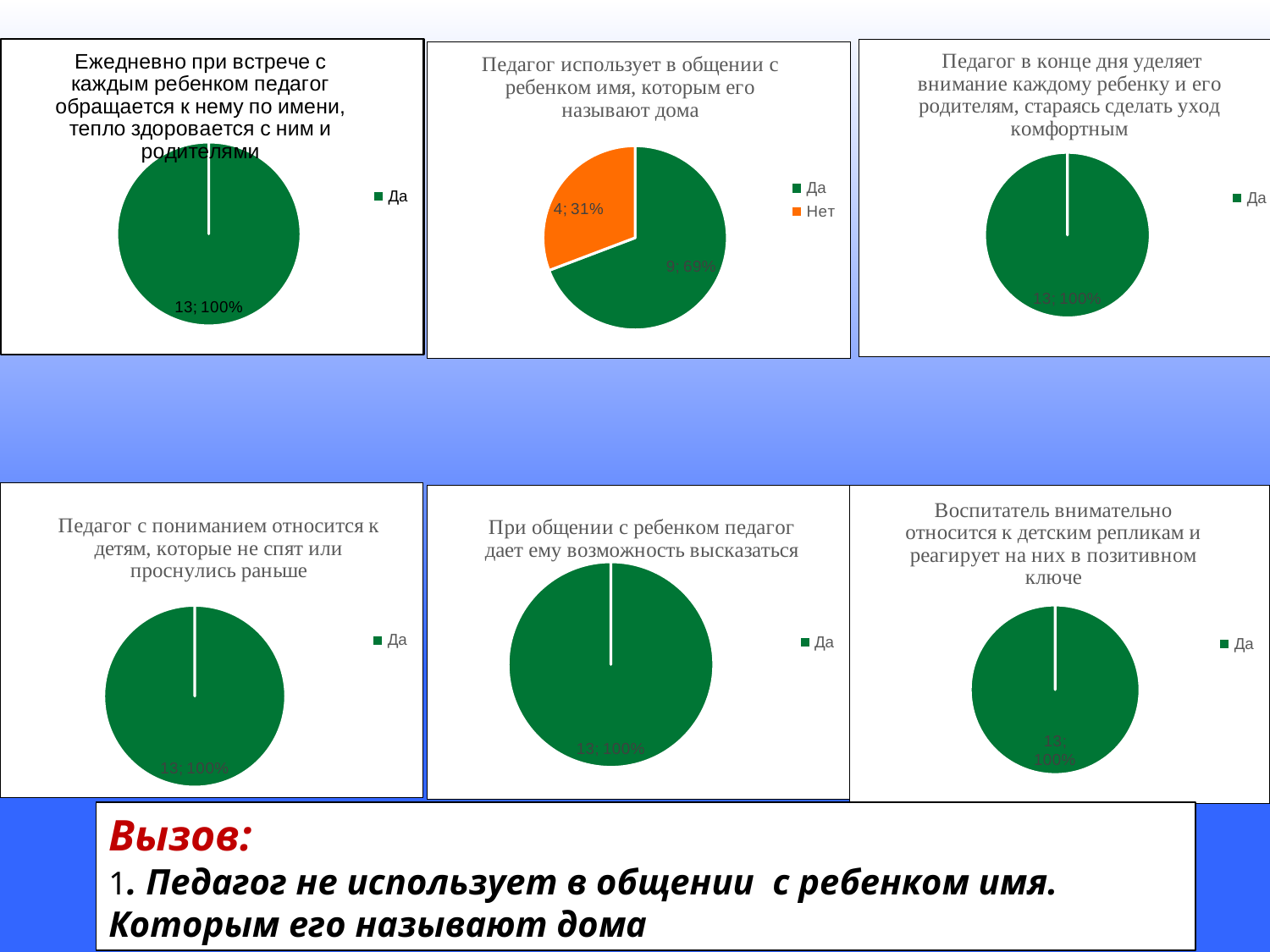
In the top-middle pie chart ("Педагог использует в общении с ребенком имя, которым его называют дома"), what share of the pie does the "Нет" slice take? 31% In the top-middle pie chart ("Педагог использует в общении с ребенком имя, которым его называют дома"), which slice is larger, "Да" or "Нет"? Да How many pie charts are shown on the slide? 6 In the bottom-left pie chart ("Педагог с пониманием относится к детям, которые не спят или проснулись раньше"), what value is shown for "Да"? 13; 100% In the top-right pie chart ("Педагог в конце дня уделяет внимание каждому ребенку и его родителям..."), what share of the pie does "Да" take? 100% How many entries does the legend of the bottom-middle pie chart ("При общении с ребенком педагог дает ему возможность высказаться") list? 1 In the top-middle pie chart ("Педагог использует в общении с ребенком имя, которым его называют дома"), what is the difference in count between "Да" and "Нет"? 5 In the top-middle pie chart ("Педагог использует в общении с ребенком имя, которым его называют дома"), what is the value shown for "Нет"? 4; 31% What type of chart is the bottom-right chart ("Воспитатель внимательно относится к детским репликам и реагирует на них в позитивном ключе")? Pie chart How many entries does the legend of the top-middle pie chart ("Педагог использует в общении с ребенком имя, которым его называют дома") list? 2 In the top-left pie chart ("Ежедневно при встрече с каждым ребенком педагог обращается к нему по имени..."), what value is shown for "Да"? 13; 100% In the top-middle pie chart ("Педагог использует в общении с ребенком имя, которым его называют дома"), what is the value shown for "Да"? 9; 69%